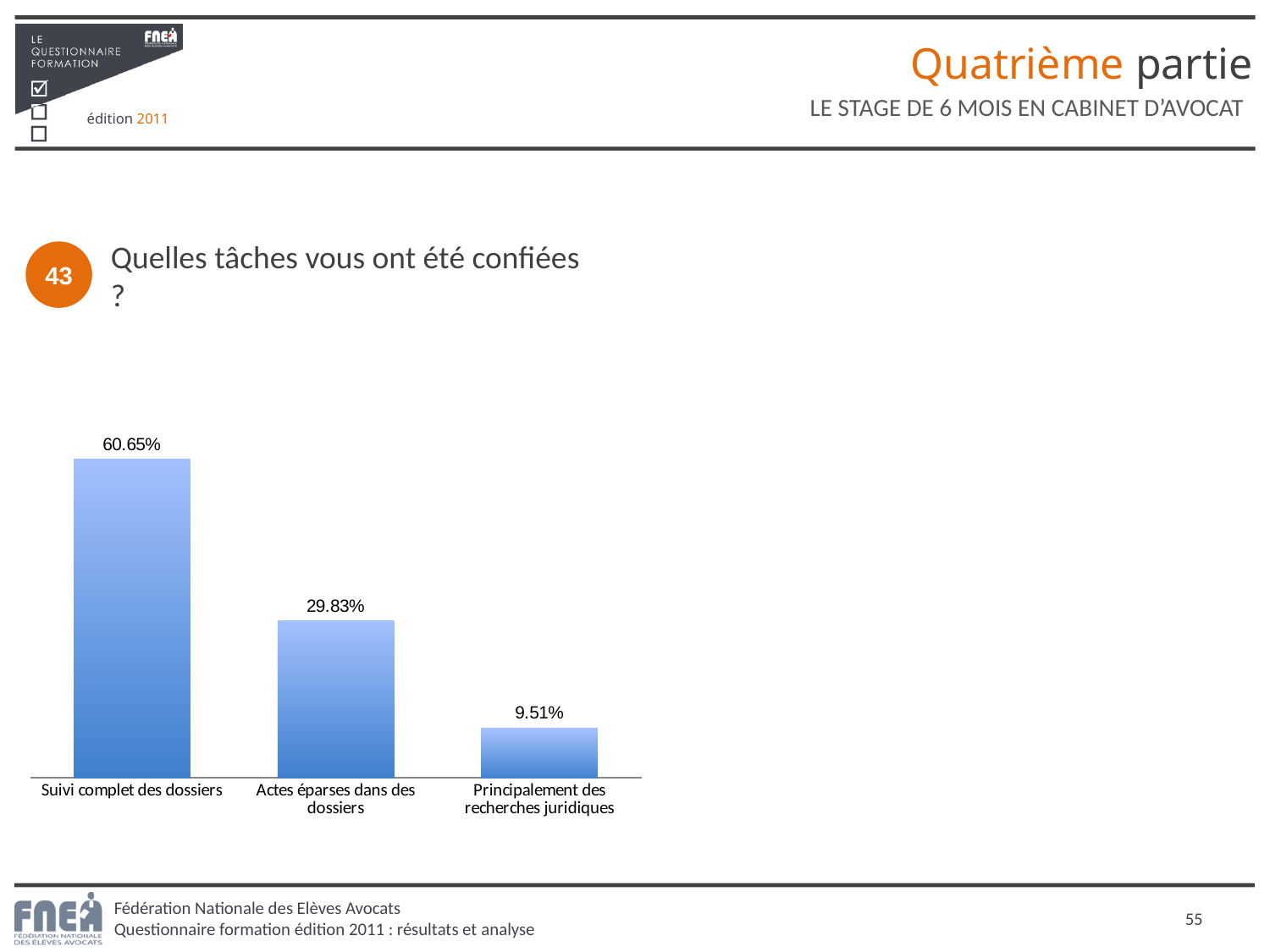
What is the difference between the values for "Actes éparses dans des dossiers" and "Principalement des recherches juridiques"? 20.32% What percentage is shown for "Actes éparses dans des dossiers"? 29.83% Do the values rise or fall from left to right across the categories? Fall What percentage is shown for "Principalement des recherches juridiques"? 9.51% How many categories are shown in the chart? 3 Which category has the lowest value? Principalement des recherches juridiques What is the difference between the values for "Suivi complet des dossiers" and "Actes éparses dans des dossiers"? 30.82% What question does the chart on the slide answer? Quelles tâches vous ont été confiées ? What kind of chart is shown on the slide? Bar chart Which category has the highest value? Suivi complet des dossiers Which is larger: the value for "Actes éparses dans des dossiers" or for "Principalement des recherches juridiques"? Actes éparses dans des dossiers What percentage is shown for "Suivi complet des dossiers"? 60.65%